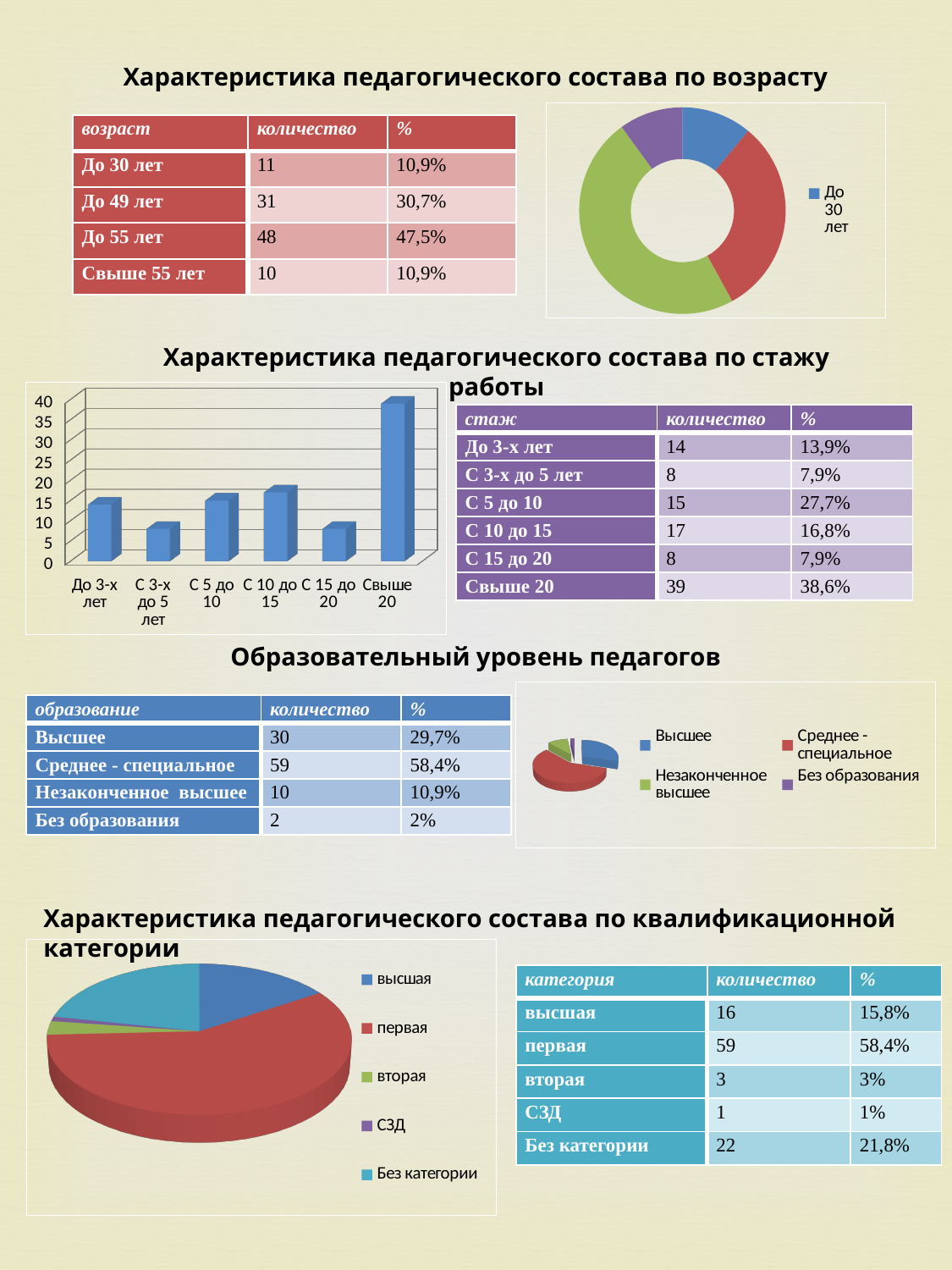
According to the qualification category table, what is the difference in количество between 'Без категории' and 'высшая'? 6 In the bar chart on work experience, is the value for 'С 3-х до 5 лет' greater or less than 10? less According to the age table, what percentage corresponds to 'До 55 лет'? 47,5% In the age donut chart, which age group has the largest share? До 55 лет In the bar chart on work experience, how many categories are shown on the x axis? 6 In the bar chart on work experience, which category has the highest bar? Свыше 20 What type of chart is shown in the section 'Характеристика педагогического состава по стажу работы'? bar chart According to the work experience table, what is the количество for 'Свыше 20'? 39 In the qualification category pie chart, which category has the largest slice? первая In the bar chart on work experience, which is larger: the bar for 'С 10 до 15' or the bar for 'С 15 до 20'? С 10 до 15 In the bar chart on work experience, is the value for 'Свыше 20' greater or less than 35? greater How many entries does the legend of the education pie chart ('Образовательный уровень педагогов') list? 4